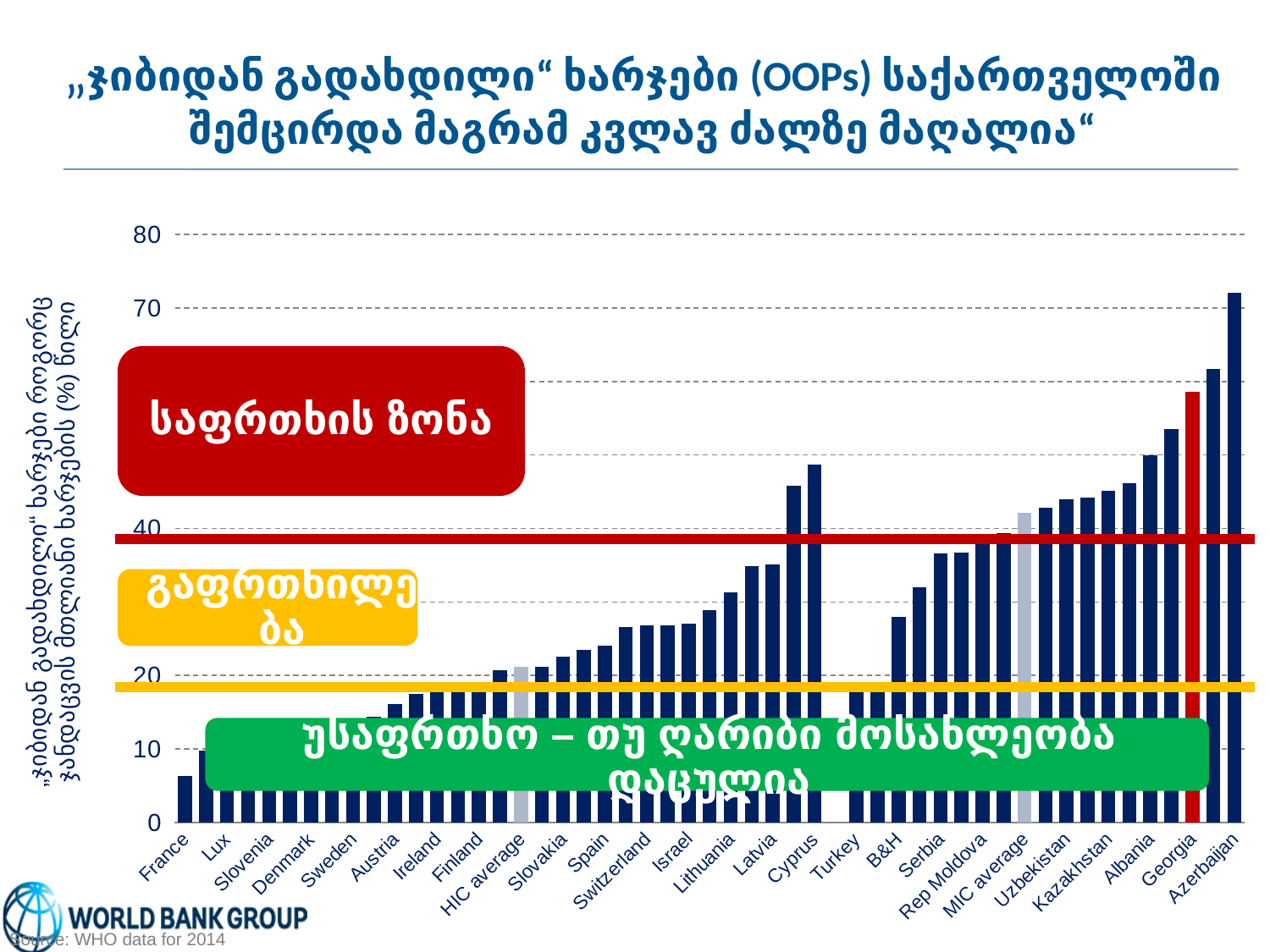
What kind of chart is shown on the slide? bar chart Which country has the lowest bar on the chart? France Do the bar values generally rise or fall from left to right along the x axis? rise Is the value for Cyprus greater or less than 40? greater Is the value for MIC average greater or less than 40? greater Which is larger, the value for Georgia or the value for Cyprus? Georgia Is the value for France greater or less than 10? less Which country has the highest bar on the chart? Azerbaijan Which is larger, the value for Azerbaijan or the value for Georgia? Azerbaijan What colour is the bar for Georgia? red